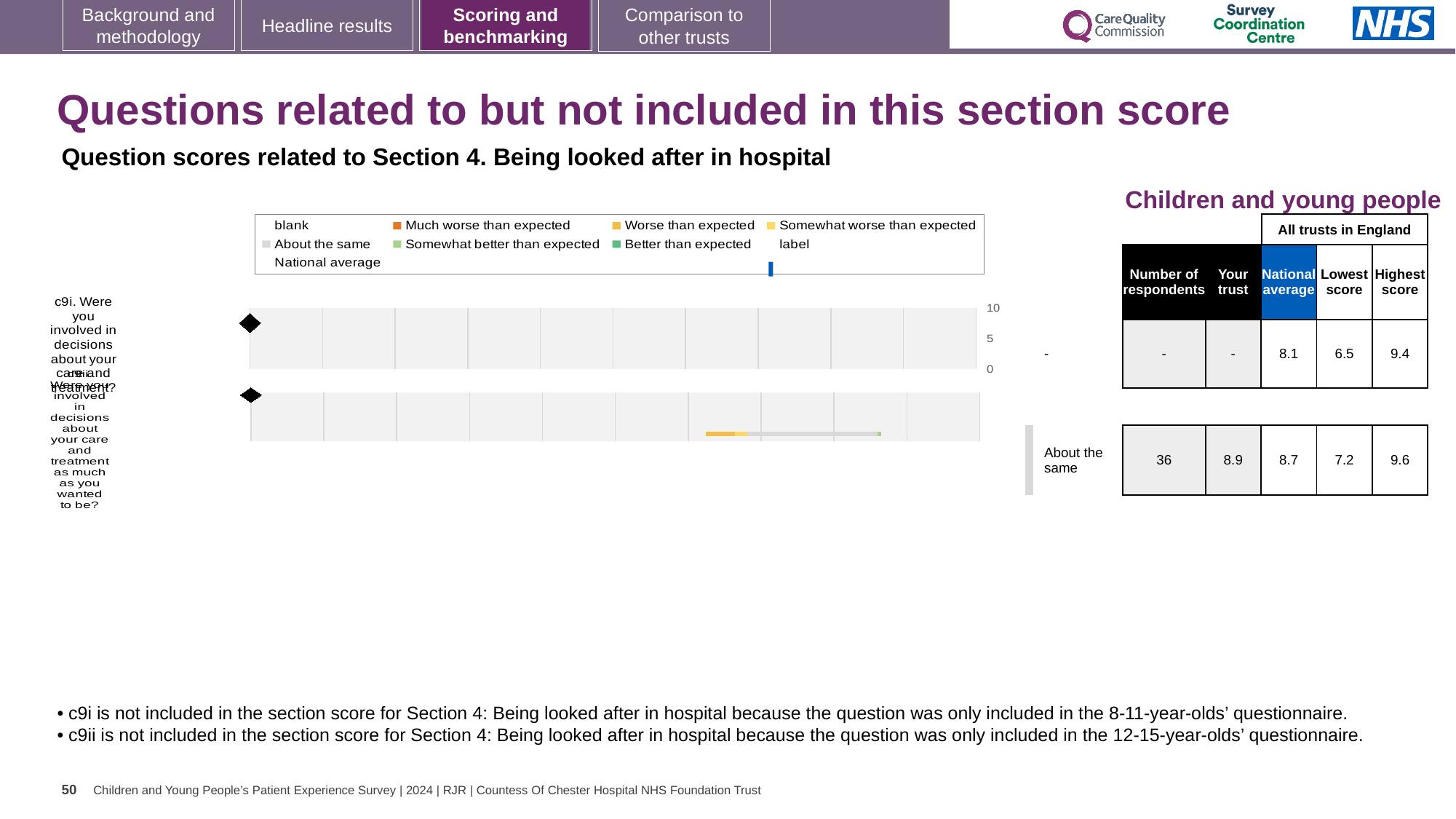
In the table, what is the lowest score across all trusts in England for c9i? 6.5 What kind of chart is shown on the slide? bar chart In the table, what is the national average score for c9ii? 8.7 In the table, what is the highest score across all trusts in England for c9ii? 9.6 How many questions (categories) are plotted in the chart? 2 In the table, how many respondents are recorded for c9ii? 36 For c9i, what is the difference between the highest score and the lowest score across all trusts in England? 2.9 For c9ii, what is the difference between the highest score and the lowest score across all trusts in England? 2.4 In the table, what is the 'Your trust' score for c9ii? 8.9 For c9ii, which is larger: the 'Your trust' score or the national average? Your trust What benchmark category label is shown next to the c9ii row? About the same